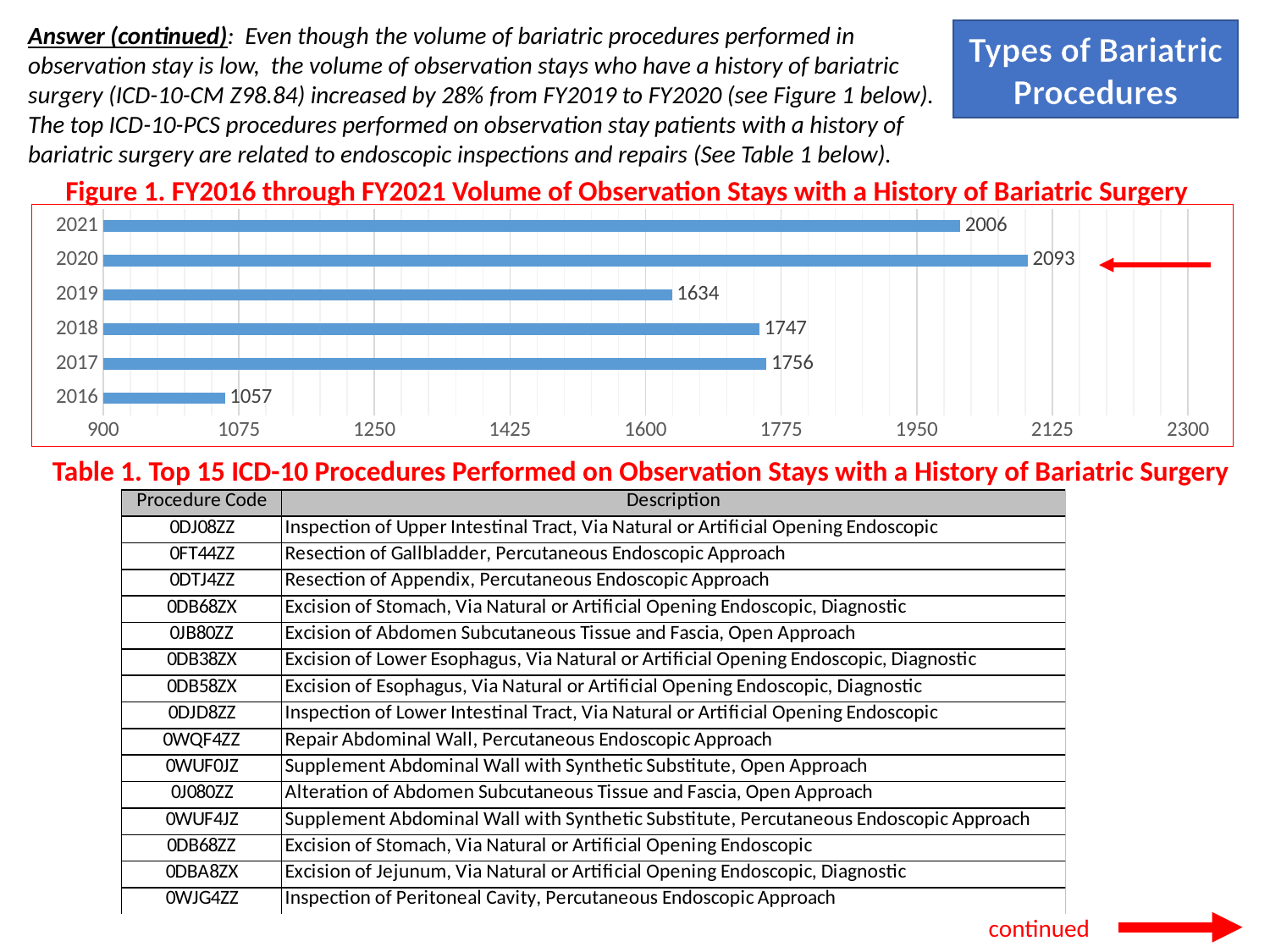
What is the volume of observation stays with a history of bariatric surgery in FY2016? 1057 What is the volume of observation stays with a history of bariatric surgery in FY2020? 2093 Which fiscal year has the lowest volume of observation stays with a history of bariatric surgery? 2016 What is the difference in volume between FY2021 and FY2016? 949 Is the value for 2021 greater or less than 1950? greater How many fiscal years are shown in Figure 1? 6 Which fiscal year has the highest volume of observation stays with a history of bariatric surgery? 2020 What is the title of the chart on the slide? Figure 1. FY2016 through FY2021 Volume of Observation Stays with a History of Bariatric Surgery What is the volume of observation stays with a history of bariatric surgery in FY2019? 1634 What is the difference in volume between FY2020 and FY2019? 459 Which year has a larger volume, 2017 or 2018? 2017 What kind of chart is Figure 1? bar chart